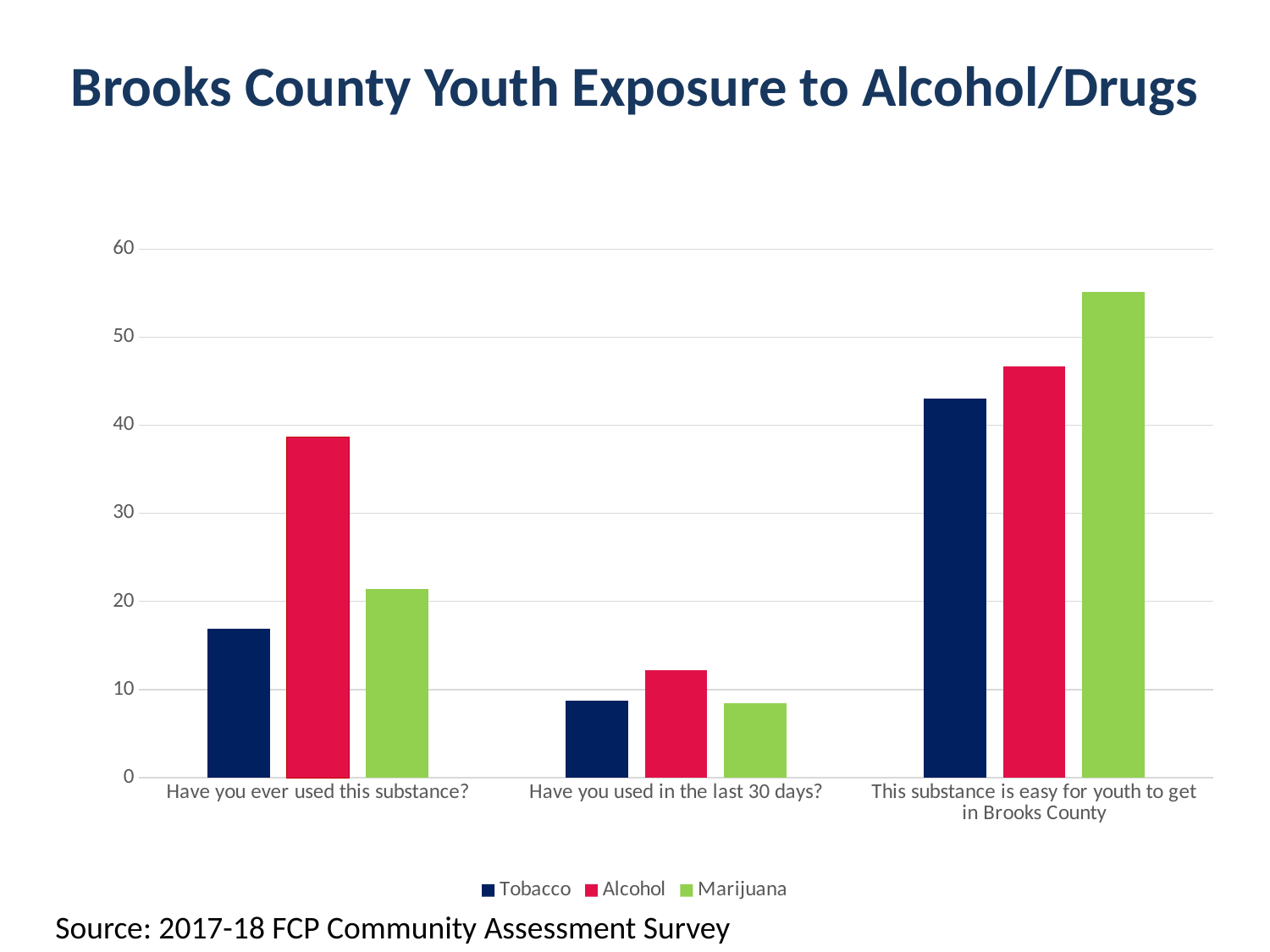
Is the Marijuana value for "This substance is easy for youth to get in Brooks County" greater or less than 50? greater Is the Alcohol value for "Have you ever used this substance?" greater or less than 30? greater Which substance has the highest value for "Have you ever used this substance?"? Alcohol What kind of chart is shown on the slide? bar chart What colour are the Marijuana bars? green Which substance has the lowest value for "Have you ever used this substance?"? Tobacco Is the Tobacco value for "Have you ever used this substance?" greater or less than 20? less For "Have you used in the last 30 days?", which is larger, the Alcohol value or the Tobacco value? Alcohol Which substance has the highest value for "This substance is easy for youth to get in Brooks County"? Marijuana How many question categories are shown on the x axis? 3 How many series does the legend list? 3